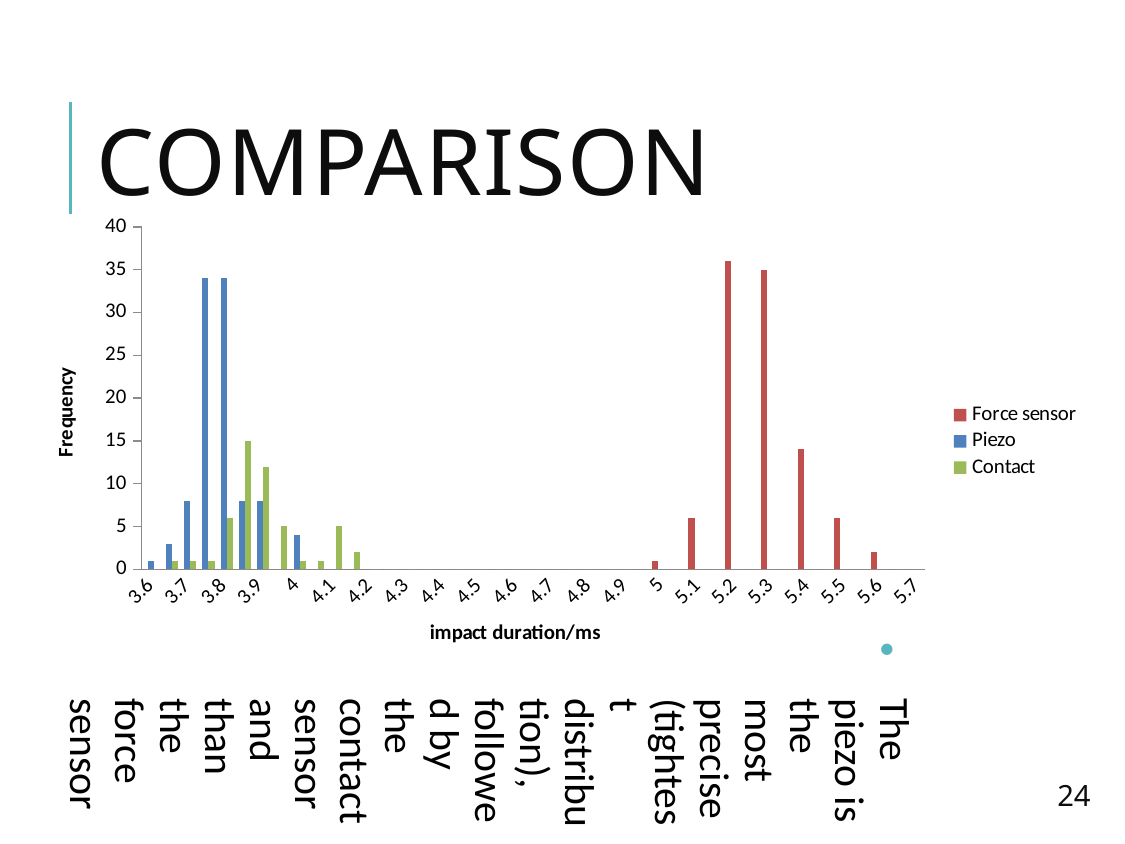
How many series does the legend list? 3 Is the Force sensor frequency at 5.4 ms greater or less than 10? greater How many impact duration categories are shown on the x axis? 22 At 3.8 ms, which series has the higher frequency, Piezo or Contact? Piezo Is the Force sensor frequency at 5.2 ms greater or less than 30? greater Is the Piezo frequency at 3.8 ms greater or less than 30? greater What is the label of the x axis? impact duration/ms What type of chart is shown on the slide? bar chart What are the three series named in the legend? Force sensor, Piezo, Contact For the Force sensor series, which is higher: the frequency at 5.2 ms or at 5.5 ms? 5.2 ms